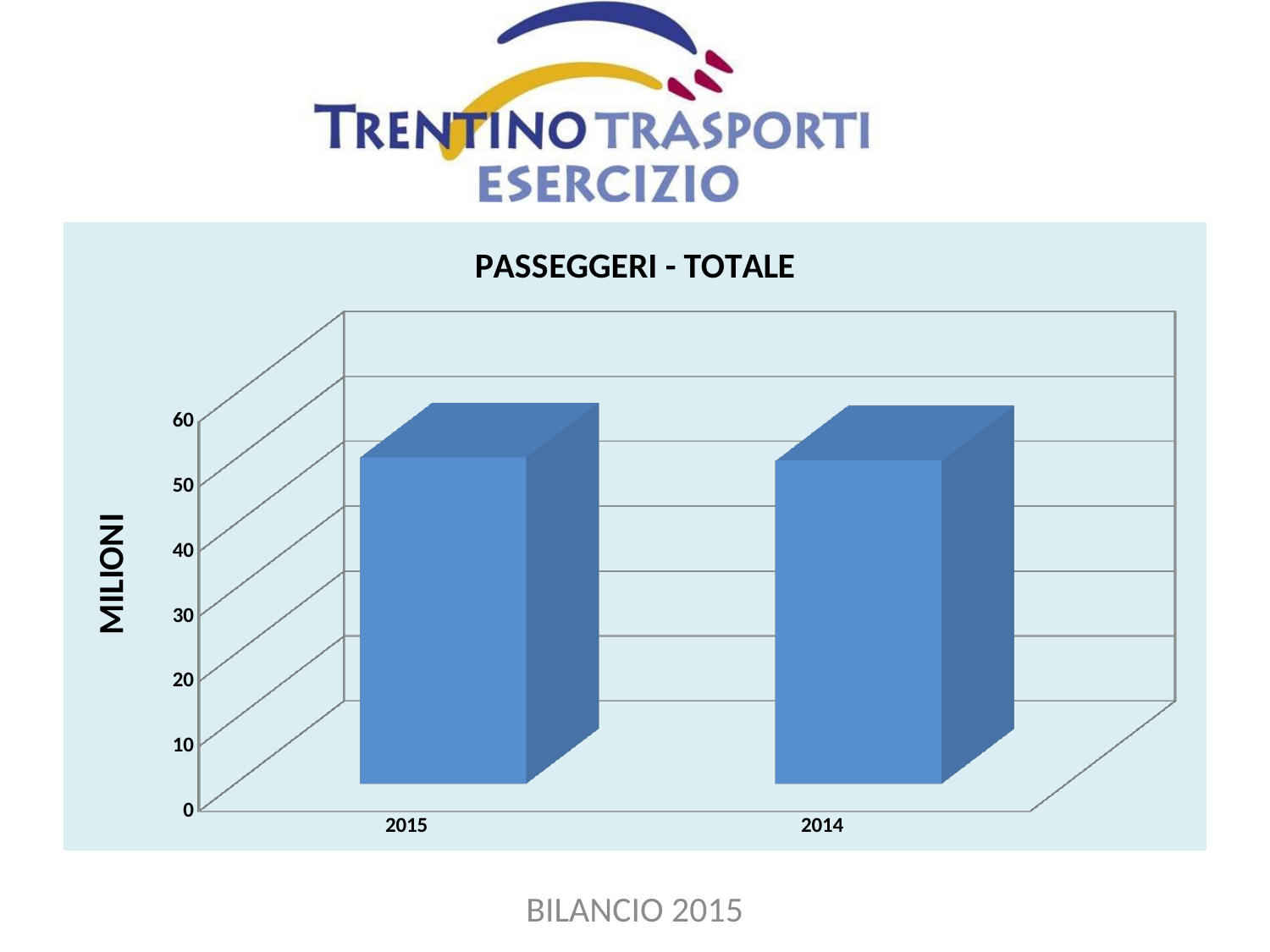
What kind of chart is shown on the slide? bar chart Is the value for 2014 greater or less than 60? less Is the value for 2015 greater or less than 60? less Is the value for 2015 greater or less than 40? greater What is the label on the vertical axis of the chart? MILIONI How many categories (years) are plotted in the chart? 2 Which years are shown on the x axis of the chart? 2015 and 2014 What is the title of the chart? PASSEGGERI - TOTALE